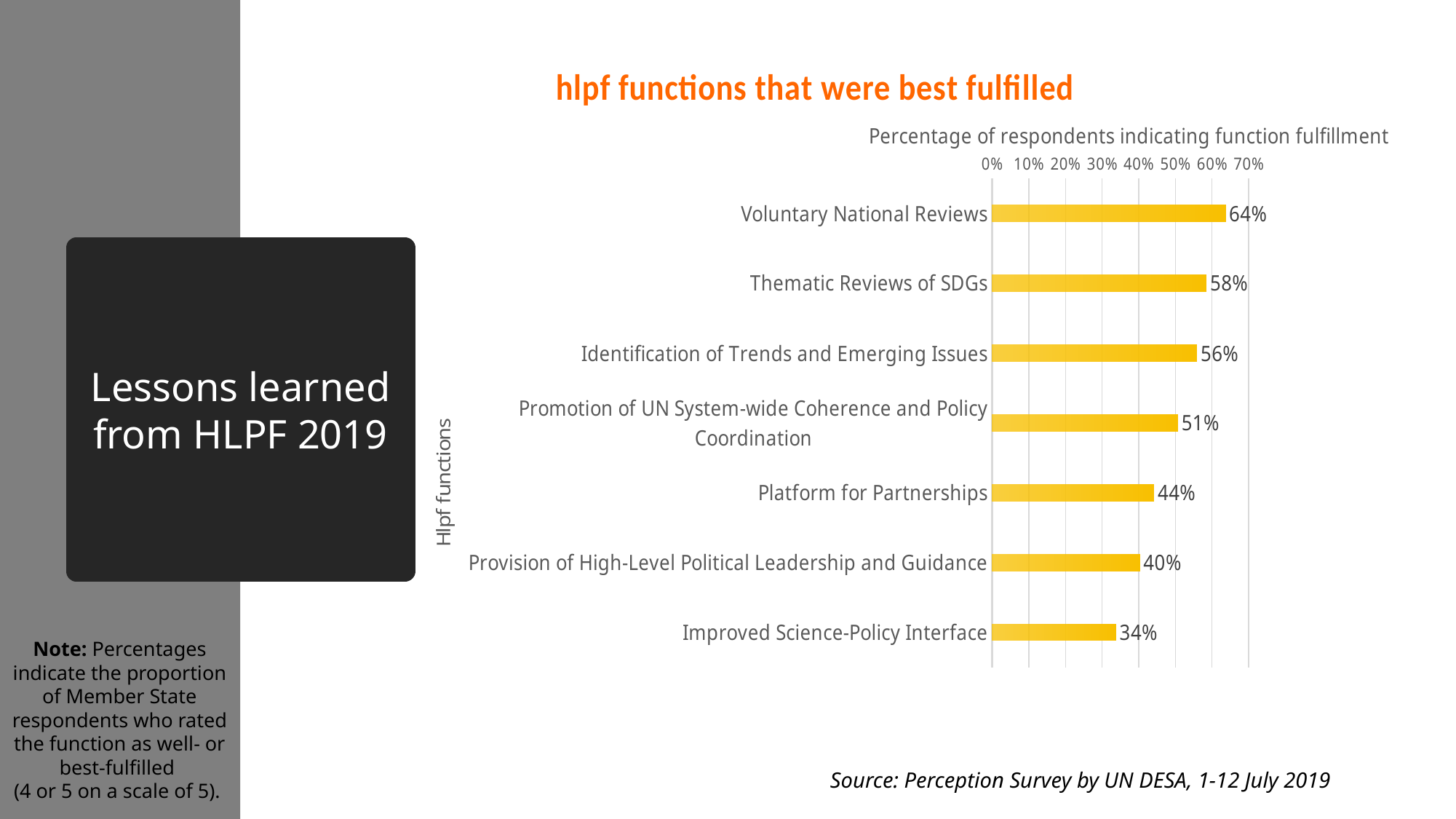
What is the difference in percentage points between Thematic Reviews of SDGs and Improved Science-Policy Interface? 24 percentage points What percentage is shown for Promotion of UN System-wide Coherence and Policy Coordination? 51% What is the value shown for Platform for Partnerships? 44% Which has a higher value: Identification of Trends and Emerging Issues or Provision of High-Level Political Leadership and Guidance? Identification of Trends and Emerging Issues Which HLPF function has the highest percentage of respondents indicating fulfillment? Voluntary National Reviews What is the label of the vertical axis of the chart? Hlpf functions Is the value for Provision of High-Level Political Leadership and Guidance greater or less than 50%? less How many HLPF functions are shown in the chart? 7 What percentage of respondents indicated fulfillment for Voluntary National Reviews? 64% What is the title of the chart? hlpf functions that were best fulfilled Which HLPF function has the lowest percentage of respondents indicating fulfillment? Improved Science-Policy Interface What type of chart is used on this slide? Bar chart